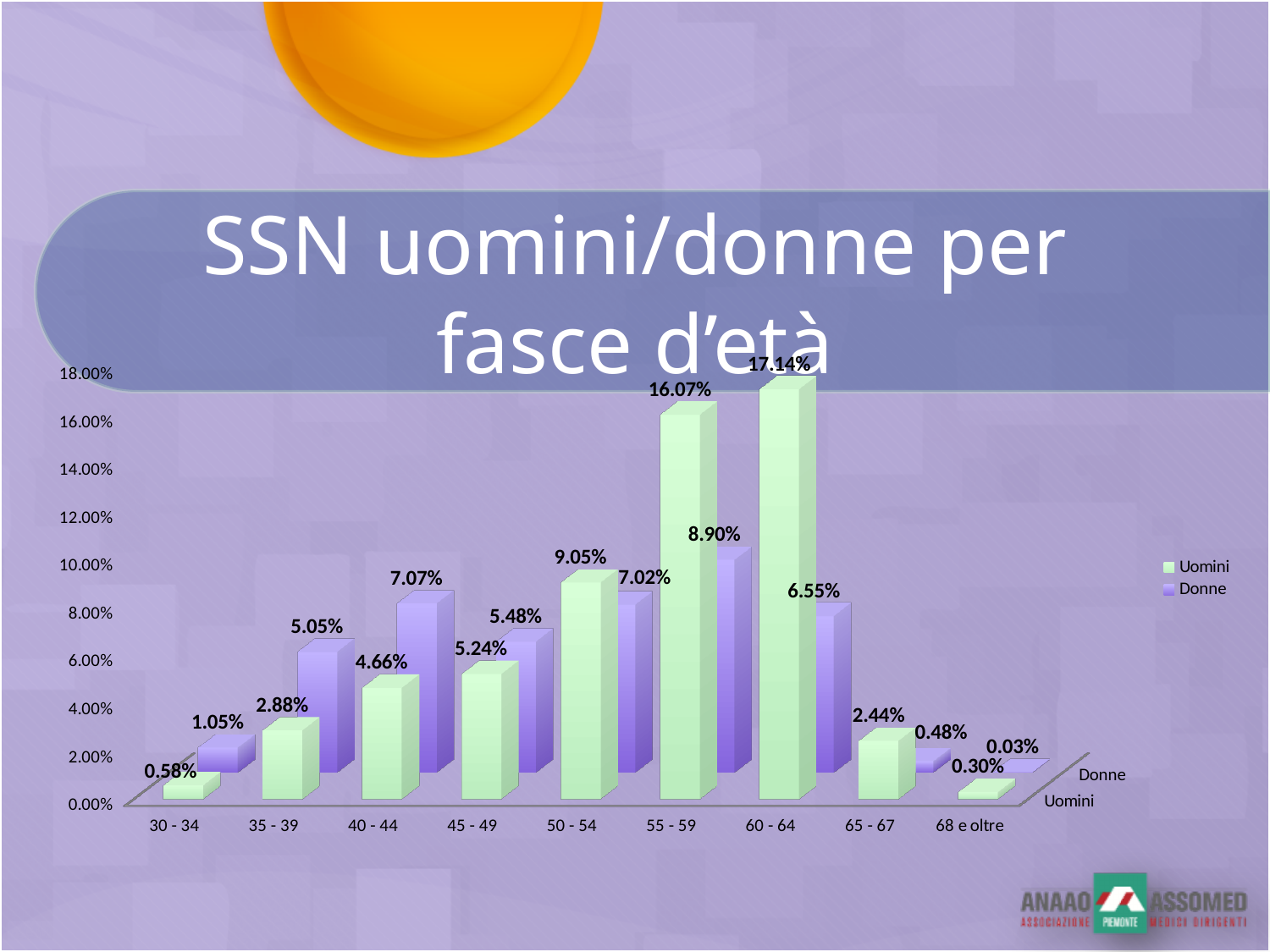
Which age group has the highest Donne value? 55 - 59 Is the Uomini value for the 50 - 54 age group greater or less than 8.00%? greater For the 35 - 39 age group, which series has the larger value, Uomini or Donne? Donne What is the difference between the Uomini and Donne values for the 55 - 59 age group? 7.17% What is the Donne value for the 40 - 44 age group? 7.07% How many age groups are shown on the x axis? 9 What is the Uomini value for the 68 e oltre age group? 0.30% What kind of chart is shown on the slide? bar chart What is the Uomini value for the 60 - 64 age group? 17.14% How many series does the legend list? 2 Which age group has the lowest Uomini value? 68 e oltre Which colour represents the Uomini series in the legend? green